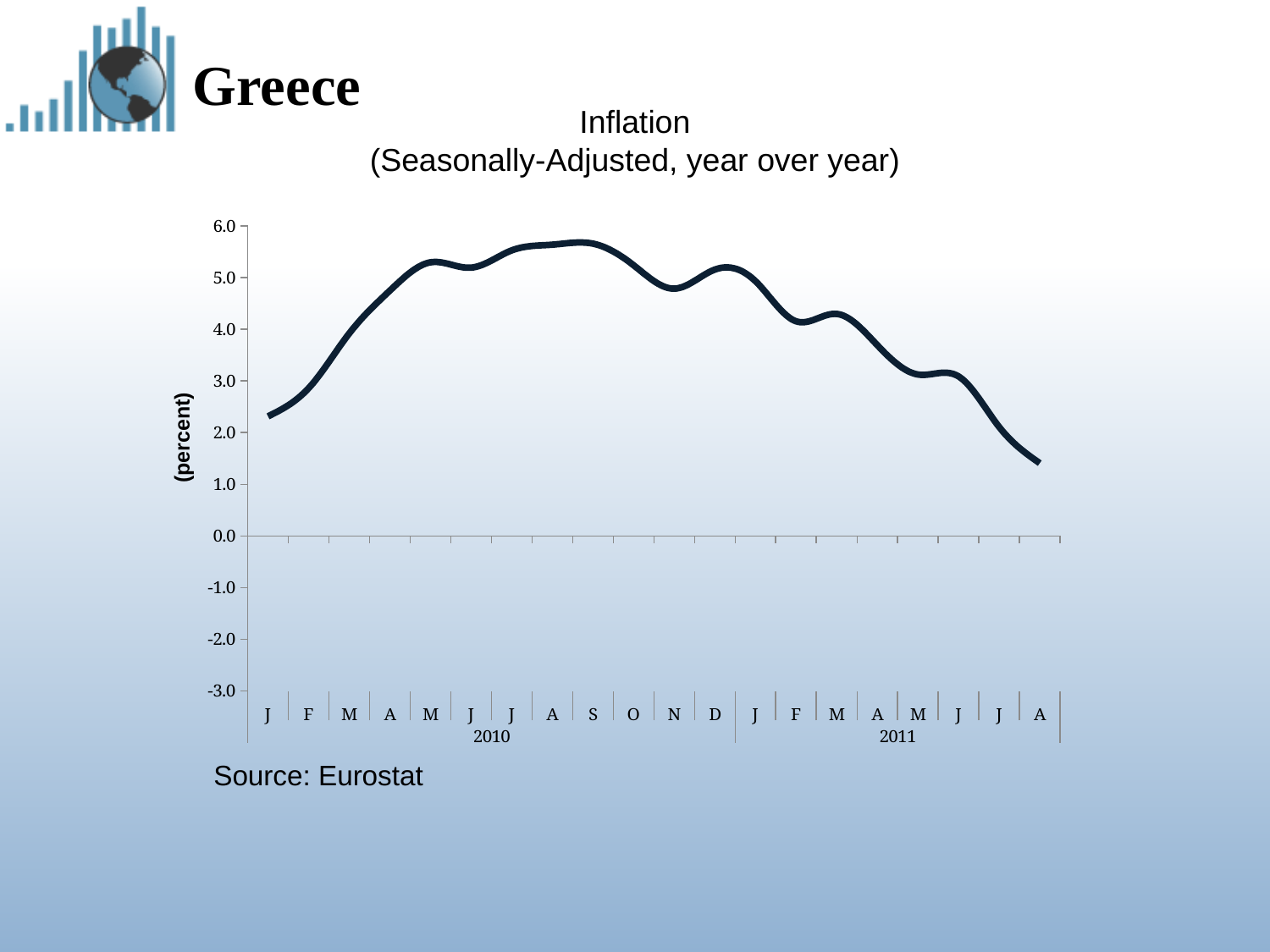
Which is larger, the inflation value for May 2010 or for March 2011? May 2010 What is the label on the vertical axis of the chart? (percent) Does inflation rise or fall from January 2010 to May 2010? rise Is the inflation value for September 2010 greater or less than 5.0? greater Is the inflation value for November 2010 greater or less than 5.0? less Is the inflation value for January 2010 greater or less than 2.0? greater Does inflation rise or fall from September 2010 to August 2011? fall Which month has the lowest inflation value on the chart? August 2011 What is the title of the chart? Inflation (Seasonally-Adjusted, year over year) How many monthly data points are plotted on the chart? 20 What kind of chart is shown on the slide? line chart